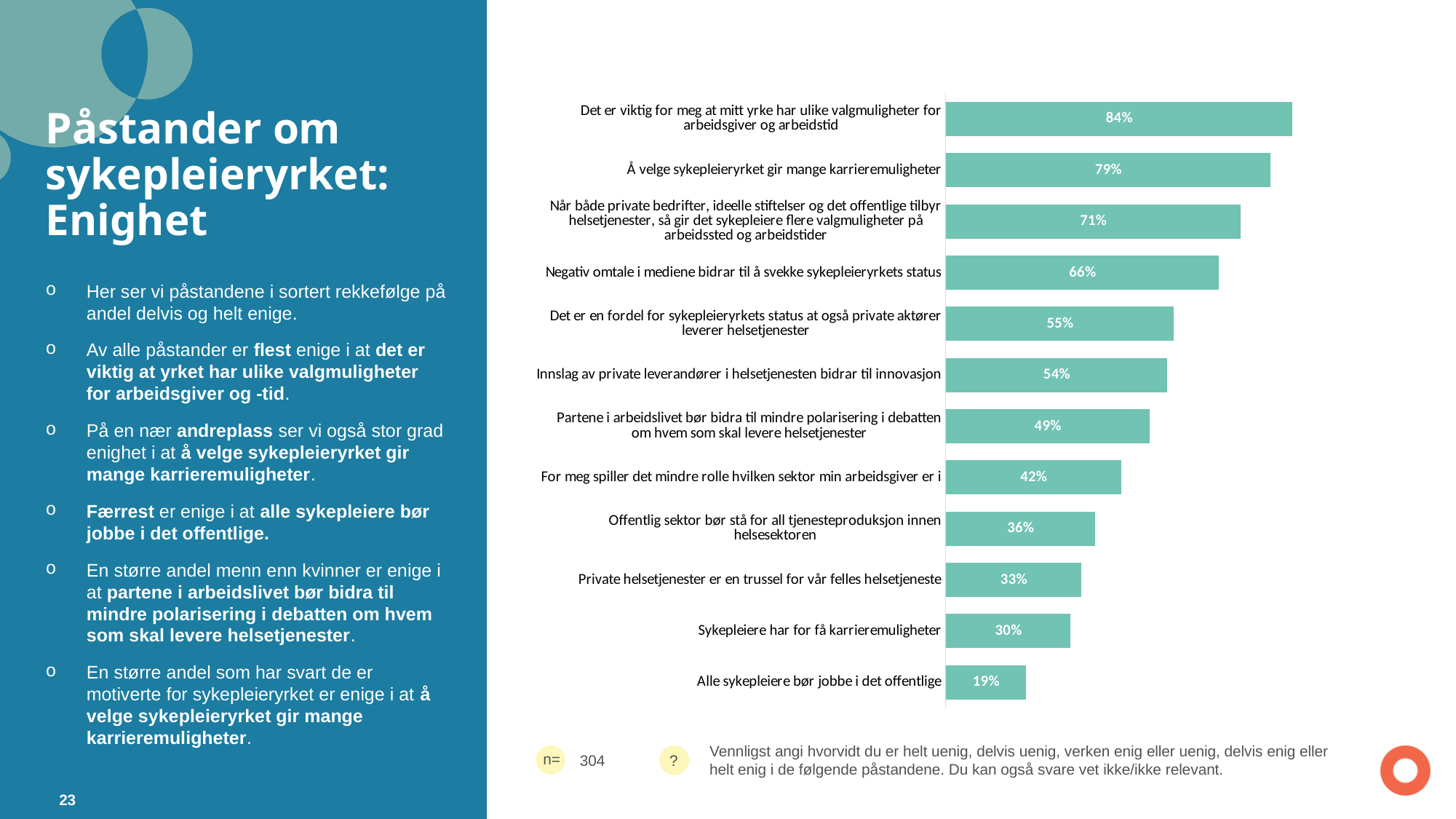
Which statement has the lowest share of agreement? Alle sykepleiere bør jobbe i det offentlige Do the values increase or decrease from the top bar to the bottom bar? Decrease What percentage is shown for "Sykepleiere har for få karrieremuligheter"? 30% What type of chart is shown on the slide? Bar chart How many statements (bars) are shown in the chart? 12 What is the value shown for "Negativ omtale i mediene bidrar til å svekke sykepleieryrkets status"? 66% What is the sample size (n) shown below the chart? 304 What is the difference between the values for "Det er en fordel for sykepleieryrkets status at også private aktører leverer helsetjenester" and "Innslag av private leverandører i helsetjenesten bidrar til innovasjon"? 1 percentage point What percentage agrees with the statement "Å velge sykepleieryrket gir mange karrieremuligheter"? 79% What is the difference in percentage points between "Det er viktig for meg at mitt yrke har ulike valgmuligheter for arbeidsgiver og arbeidstid" and "Alle sykepleiere bør jobbe i det offentlige"? 65 percentage points Which statement has the highest share of agreement? Det er viktig for meg at mitt yrke har ulike valgmuligheter for arbeidsgiver og arbeidstid Which has a higher value: "Offentlig sektor bør stå for all tjenesteproduksjon innen helsesektoren" or "Private helsetjenester er en trussel for vår felles helsetjeneste"? Offentlig sektor bør stå for all tjenesteproduksjon innen helsesektoren